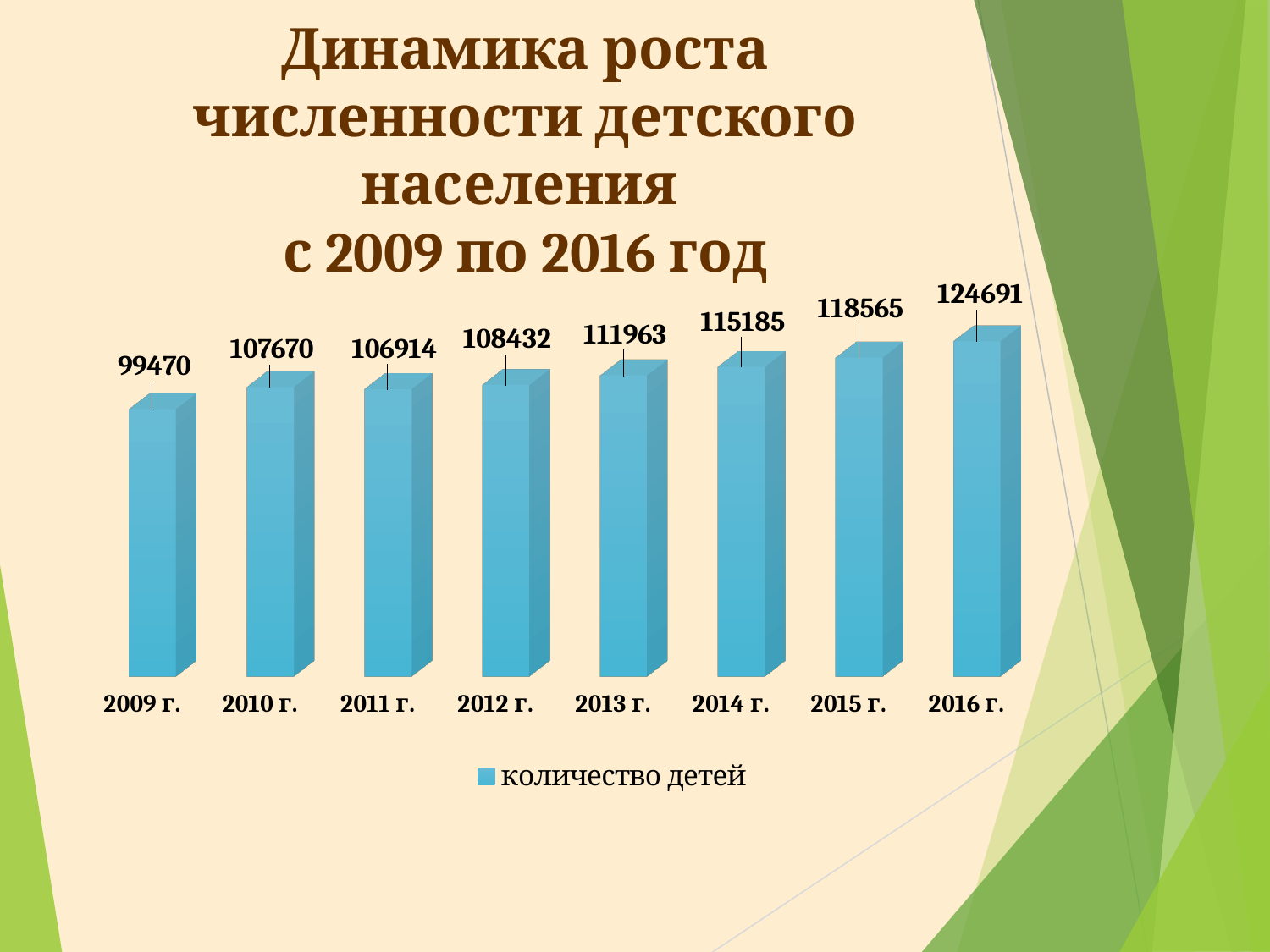
What is the legend entry of the chart? количество детей What is the value for 2013 г.? 111963 How many years are shown on the chart? 8 Which year has the lowest value? 2009 г. What is the value for 2016 г.? 124691 Which is larger, the value for 2010 г. or the value for 2011 г.? 2010 г. What is the value for 2009 г.? 99470 What kind of chart is shown on the slide? bar chart What is the difference between the values for 2016 г. and 2009 г.? 25221 How many series does the legend list? 1 Which year has the highest value? 2016 г. What is the difference between the values for 2015 г. and 2014 г.? 3380